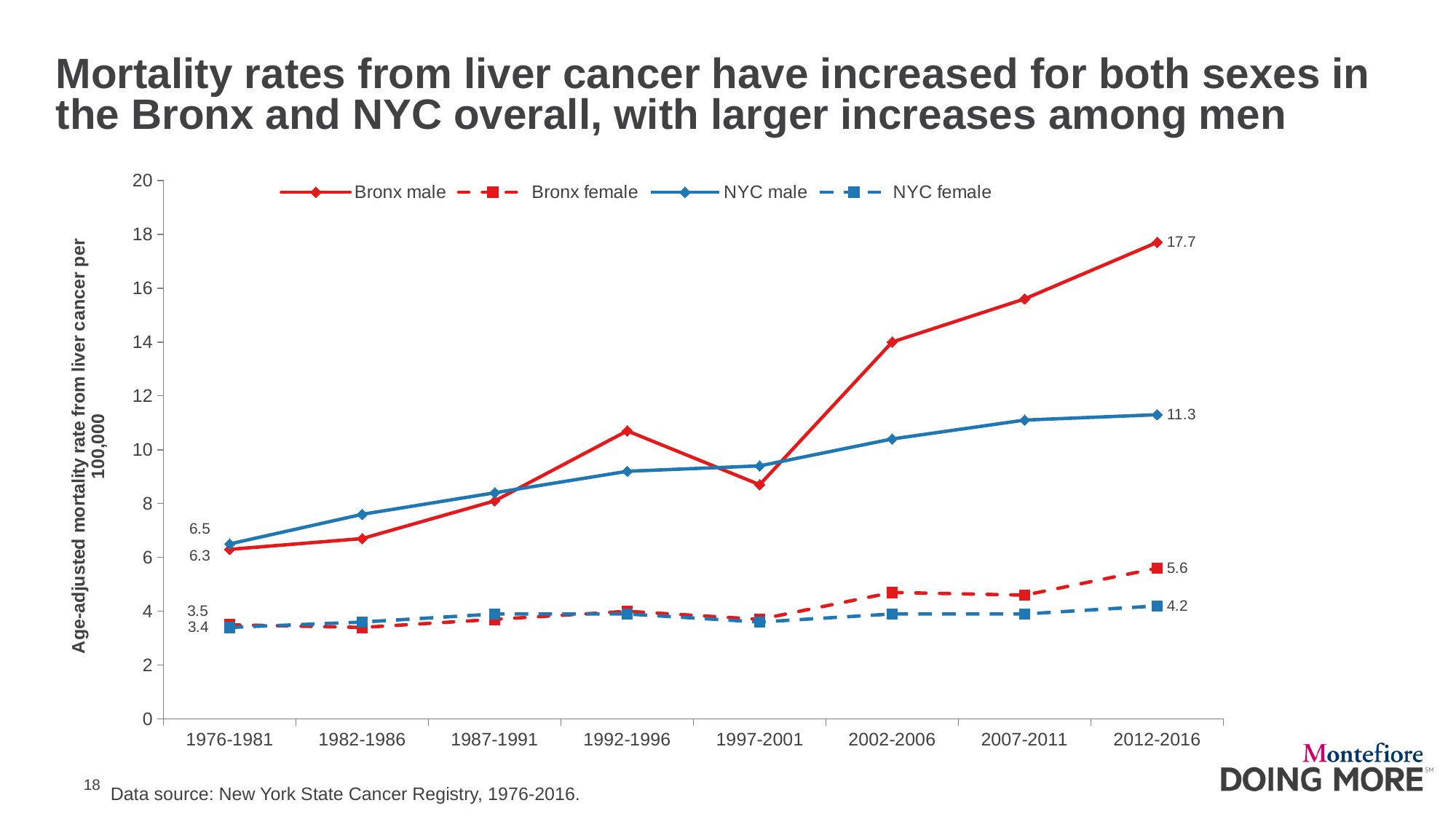
What is the NYC female mortality rate for 2012-2016? 4.2 What is the difference between the Bronx male and NYC male rates in 2012-2016? 6.4 Is the Bronx male value for 2002-2006 greater or less than 12? greater What is the Bronx male mortality rate for 2012-2016? 17.7 How many time periods are shown on the x axis? 8 What type of chart is shown on the slide? line chart What is the Bronx female mortality rate for 1976-1981? 3.5 How many series does the legend list? 4 Which series has the lowest value in 1976-1981? NYC female What is the NYC male mortality rate for 2012-2016? 11.3 Does the NYC male series rise or fall from 1976-1981 to 2012-2016? rise Which series has the highest value in 2012-2016? Bronx male